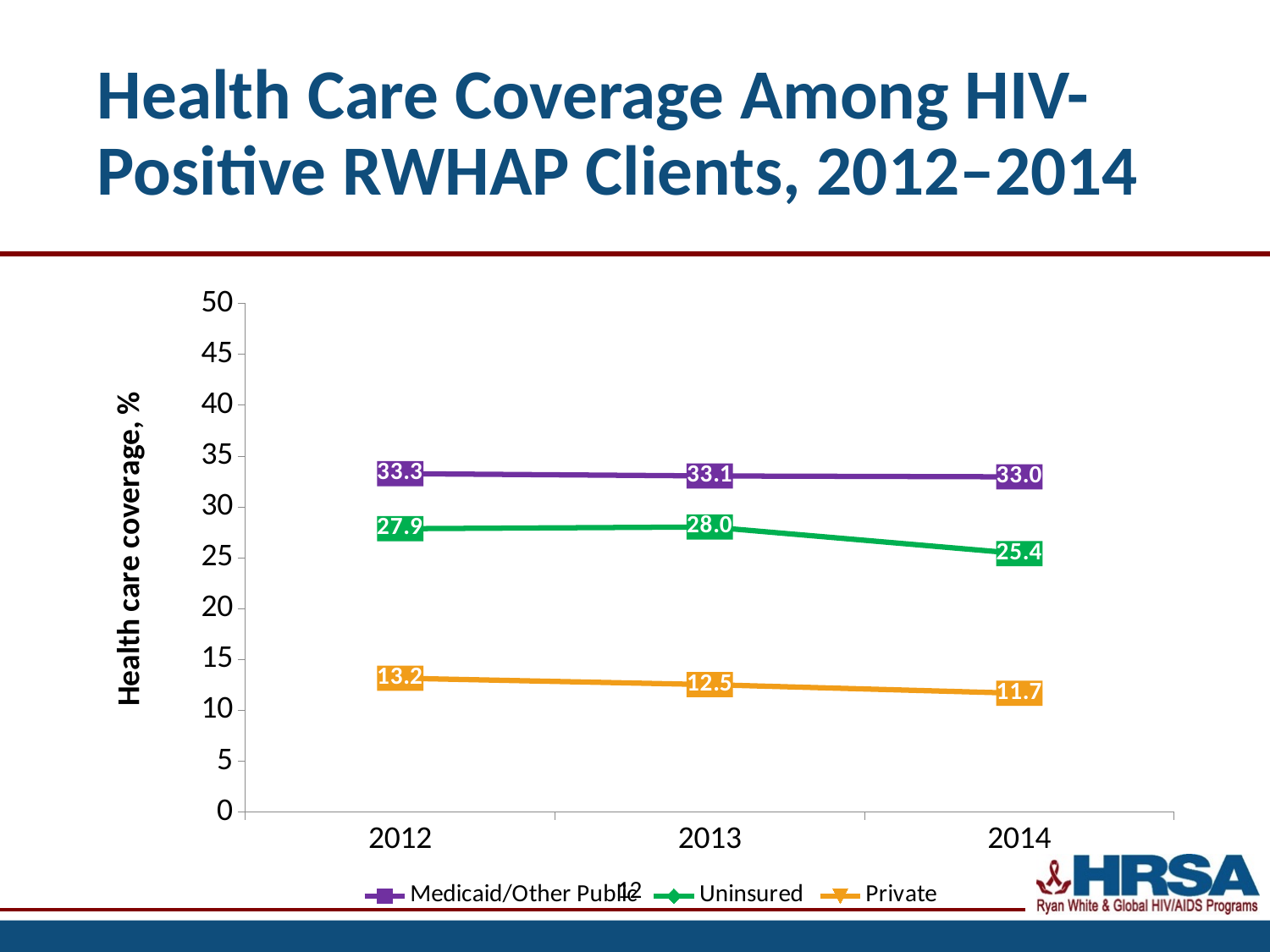
What is the difference between the Private values in 2012 and 2014? 1.5 How many series does the legend list? 3 Does the Private series rise or fall from 2012 to 2014? fall Which is larger: the Uninsured value in 2012 or the Private value in 2012? Uninsured What was the Uninsured coverage percentage in 2014? 25.4 What was the Private coverage percentage in 2013? 12.5 What was the Medicaid/Other Public coverage percentage in 2012? 33.3 What is the difference between the Uninsured values in 2013 and 2014? 2.6 Which series had the highest value in 2014? Medicaid/Other Public What kind of chart is shown on the slide? line chart Which series had the lowest value in 2012? Private How many years are shown on the x axis? 3